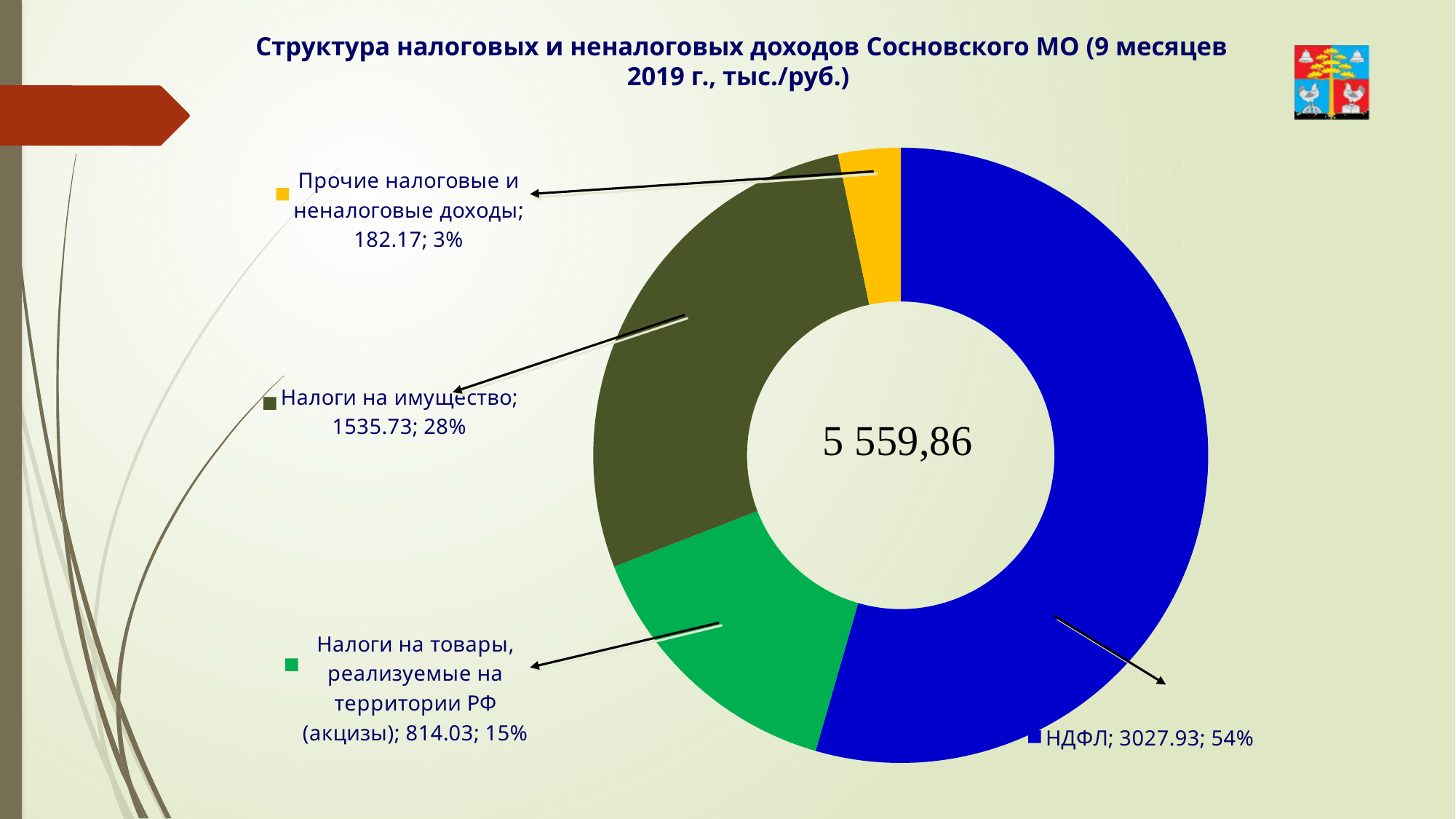
What is the difference between the values for НДФЛ and Налоги на имущество? 1492.2 How many categories are shown in the chart? 4 Which category has the largest value? НДФЛ What share of the chart does Налоги на имущество represent? 28% What share of the chart does НДФЛ represent? 54% What is the value for НДФЛ? 3027.93 What total value is printed in the centre of the chart? 5 559,86 What kind of chart is shown on the slide? Doughnut (pie) chart What is the value for Прочие налоговые и неналоговые доходы? 182.17 What is the value for Налоги на имущество? 1535.73 What is the value for Налоги на товары, реализуемые на территории РФ (акцизы)? 814.03 Which category has the smallest value? Прочие налоговые и неналоговые доходы